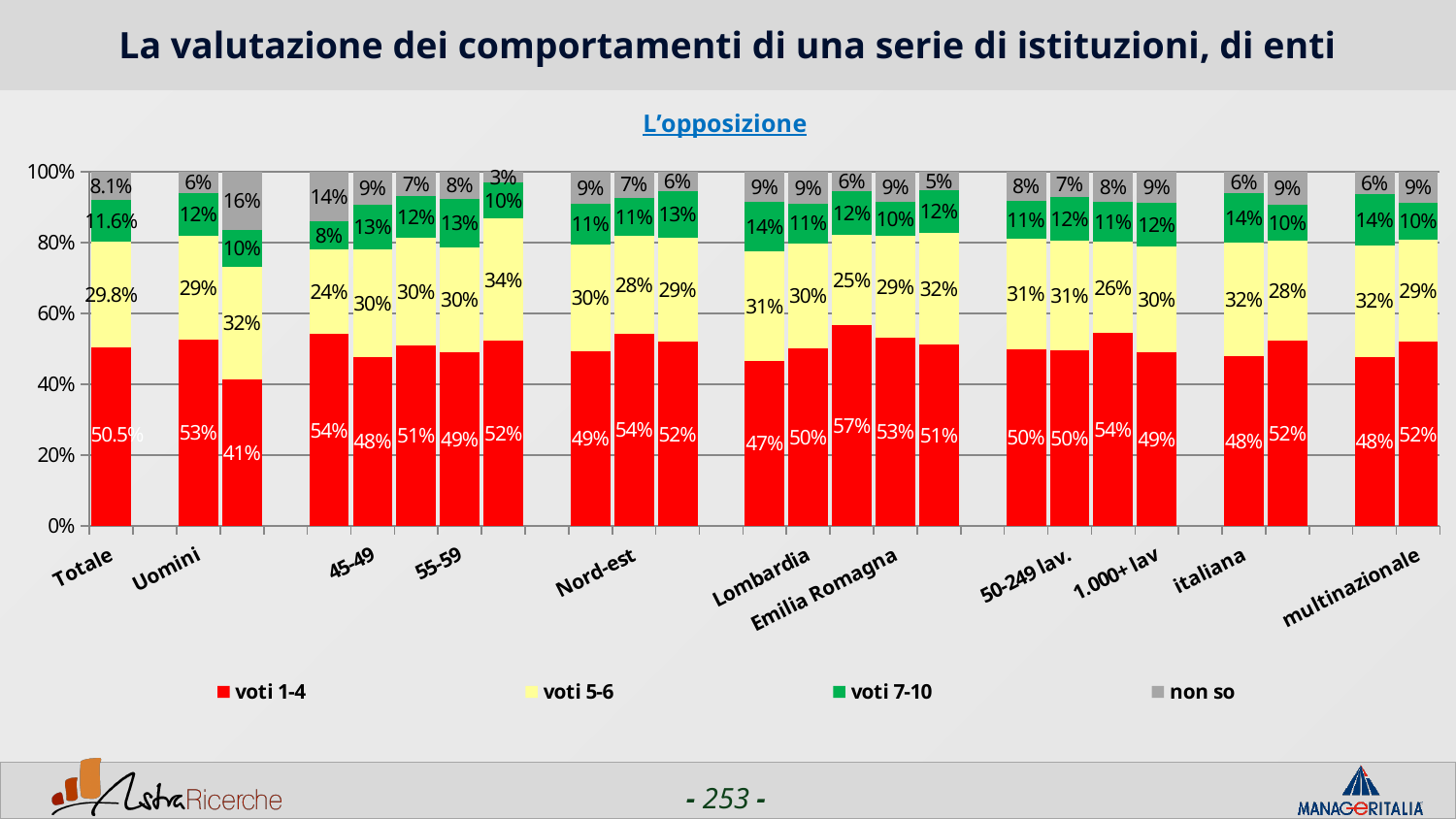
What is the value of the 'voti 1-4' segment for Totale? 50.5% What kind of chart is shown on the slide? Stacked bar chart What is the value of the 'non so' segment for Uomini? 6% How many series does the legend list? 4 Which has a larger 'voti 1-4' value, Totale or Uomini? Uomini For Totale, what is the difference between the 'voti 1-4' value and the 'voti 5-6' value? 20.7 percentage points What is the title of the chart? L'opposizione What is the value of the 'voti 7-10' segment for Uomini? 12% What is the value of the 'voti 7-10' segment for Totale? 11.6% What is the value of the 'voti 1-4' segment for Uomini? 53% What is the value of the 'non so' segment for Totale? 8.1% What is the value of the 'voti 5-6' segment for Totale? 29.8%